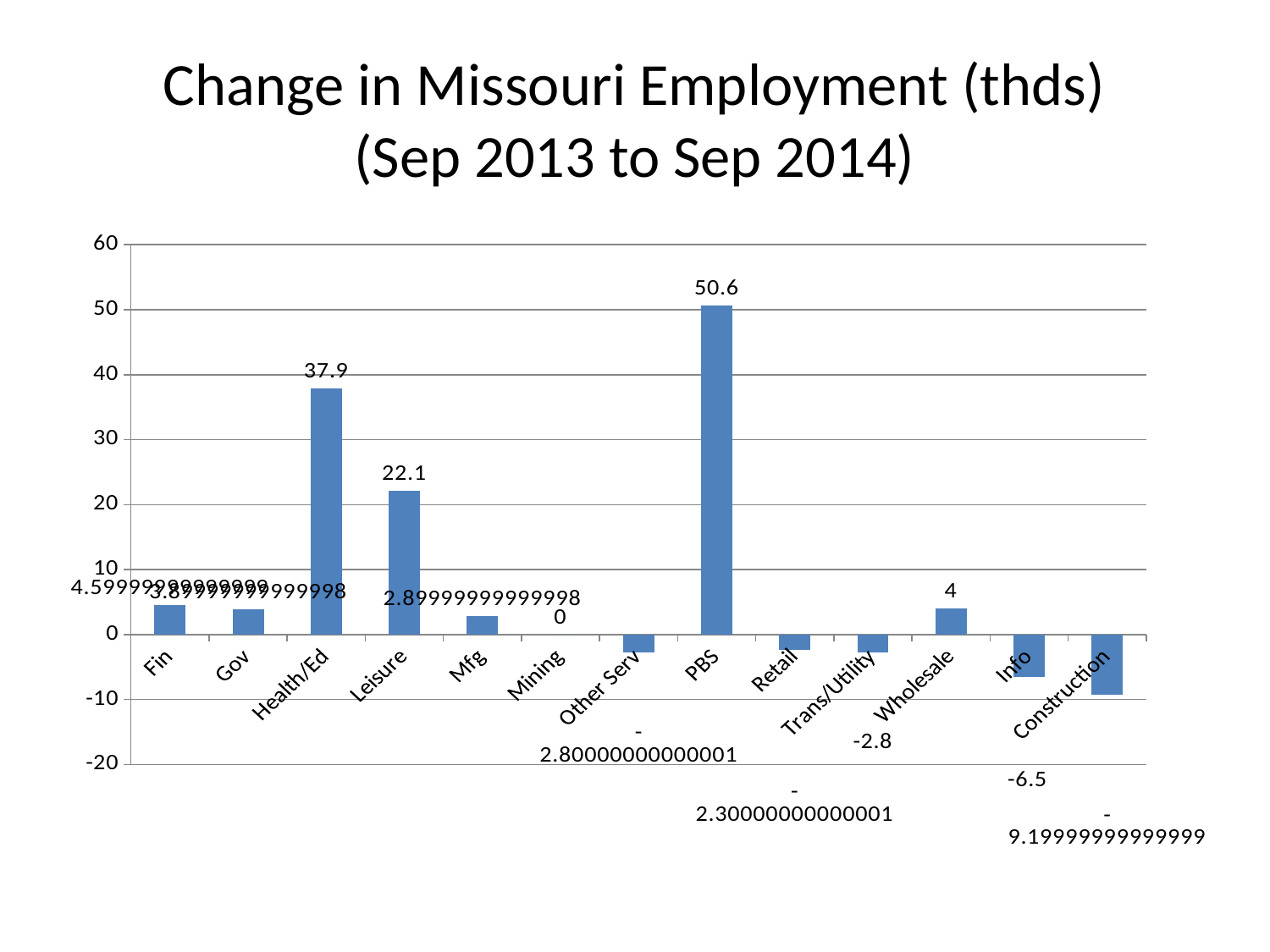
Which category has the highest value? PBS Which is larger, the value for Health/Ed or the value for Leisure? Health/Ed What is the value for Info? -6.5 How many categories are shown on the x axis? 13 What kind of chart is shown on the slide? Bar chart What is the difference between the values for PBS and Health/Ed? 12.7 What is the value for PBS? 50.6 What is the value for Wholesale? 4 Which category has the lowest value? Construction What is the value for Mining? 0 What is the value for Health/Ed? 37.9 What is the value for Leisure? 22.1